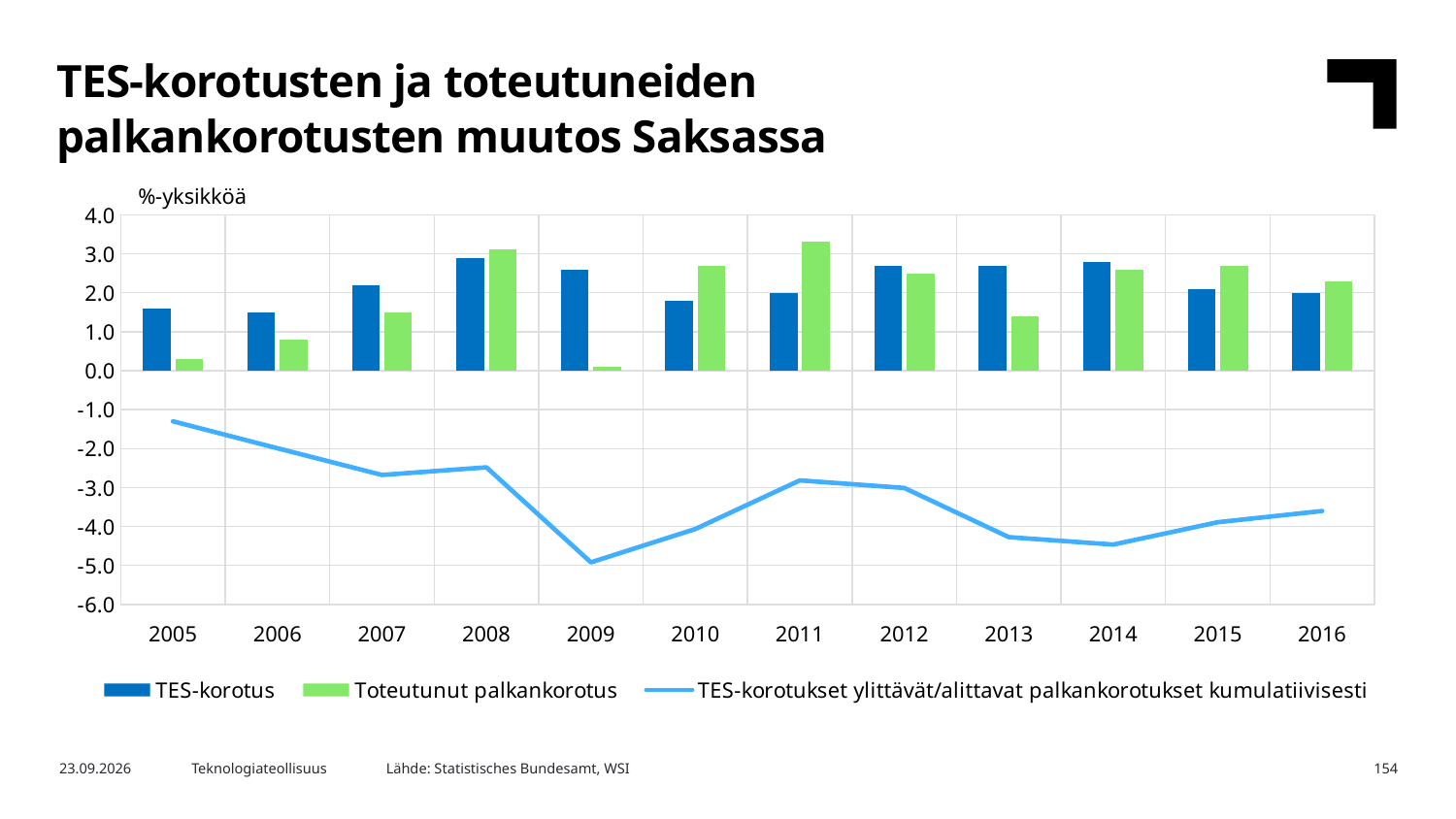
What kind of chart is shown on the slide? A combined bar and line chart In which year is the Toteutunut palkankorotus bar highest? 2011 Is the Toteutunut palkankorotus value for 2005 greater or less than 1.0? less In which year does the line 'TES-korotukset ylittävät/alittavat palkankorotukset kumulatiivisesti' reach its lowest point? 2009 Is the TES-korotus value for 2008 greater or less than 2.0? greater How many series does the legend list? 3 In 2011, which is larger: TES-korotus or Toteutunut palkankorotus? Toteutunut palkankorotus What unit label is shown above the y axis? %-yksikköä How many years are shown on the x axis? 12 In which year is the Toteutunut palkankorotus bar lowest? 2009 Does the cumulative line rise or fall from 2014 to 2016? rises In 2009, which is larger: TES-korotus or Toteutunut palkankorotus? TES-korotus